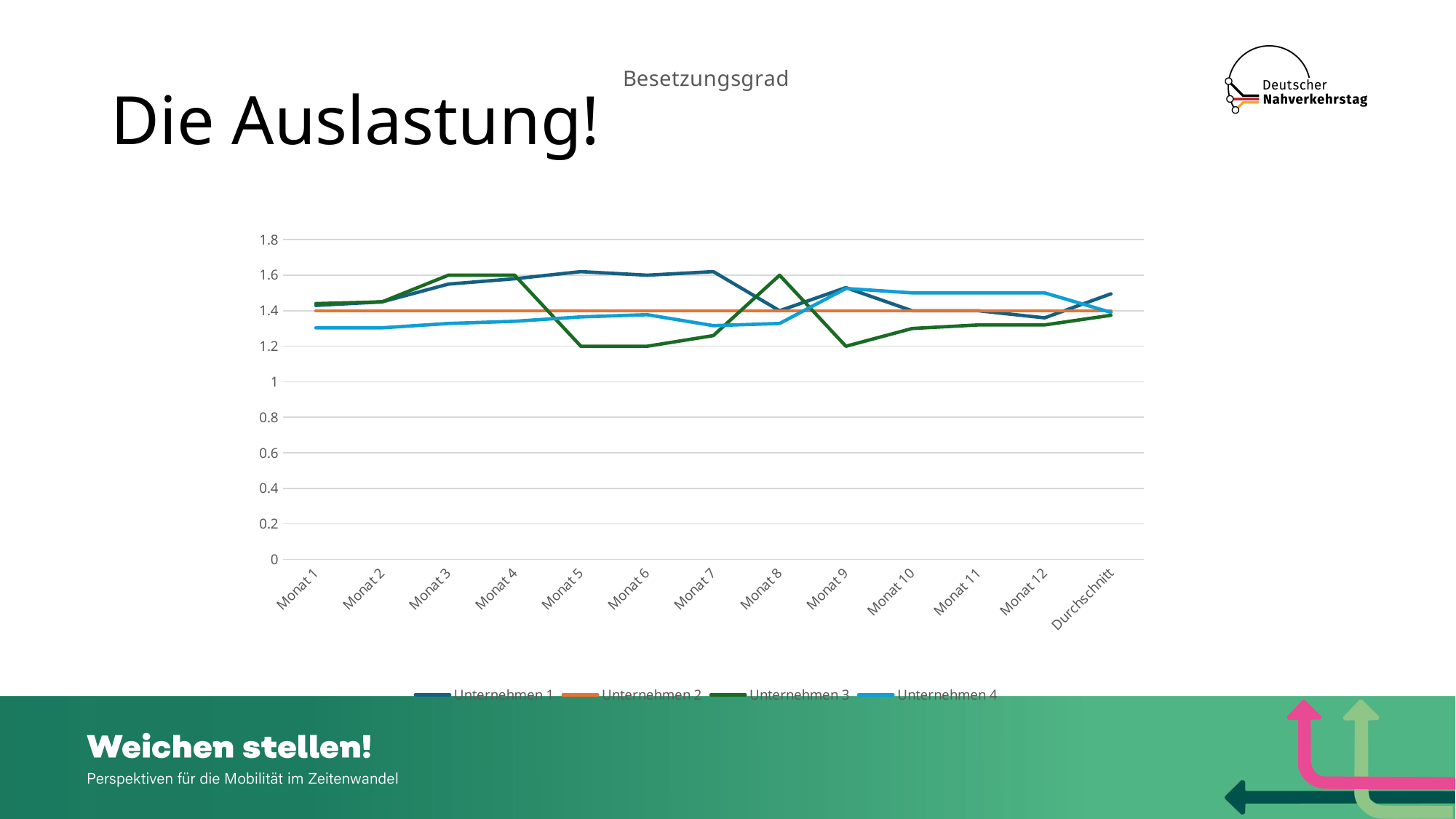
Does the line for Unternehmen 2 rise, fall or stay flat across the months? stays flat What is the title of the chart? Besetzungsgrad Which series has the lowest value at Monat 9? Unternehmen 3 Which colour is used for Unternehmen 2 in the legend? orange What kind of chart is shown on the slide? line chart Is the value for Unternehmen 4 at Monat 1 greater or less than 1.4? less What is the value for Unternehmen 2 at Monat 1? 1.4 At Monat 5, which is larger: Unternehmen 1 or Unternehmen 3? Unternehmen 1 How many series does the legend list? 4 Is the value for Unternehmen 1 at Monat 7 greater or less than 1.4? greater What is the value for Unternehmen 3 at Monat 5? 1.2 How many categories are shown on the x axis? 13